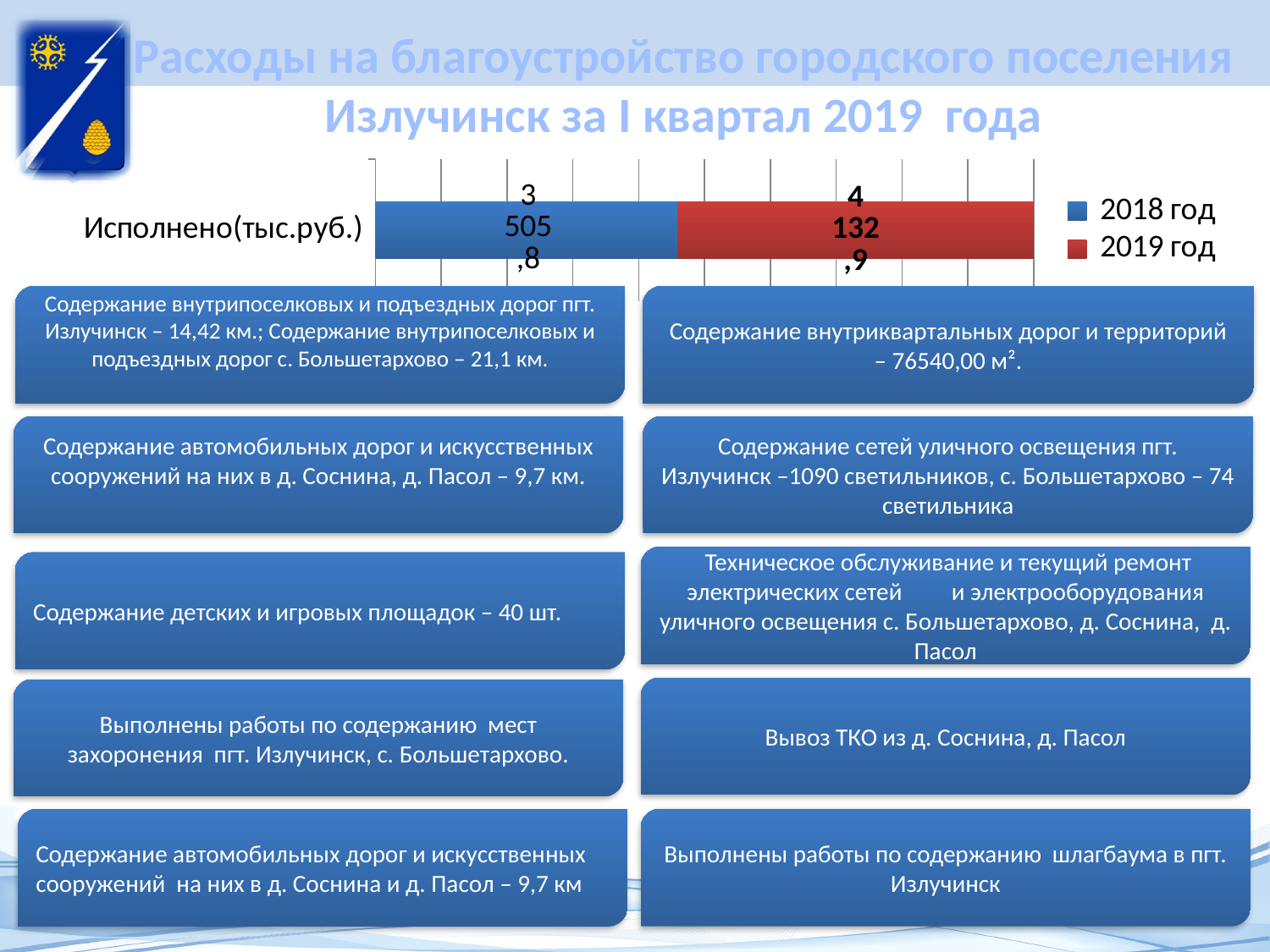
What is the difference between the 2019 год value and the 2018 год value? 627,1 What is the label of the category plotted in the chart? Исполнено(тыс.руб.) Which series has the highest value in the chart? 2019 год How many categories are plotted in the chart? 1 How many series does the legend list? 2 What kind of chart is shown on the slide? Stacked bar chart Which year has the larger value, 2018 год or 2019 год? 2019 год What is the value for 2019 год in the chart? 4 132,9 Which colour represents 2019 год in the chart? Red What is the value for 2018 год in the chart? 3 505,8 Which series has the lowest value in the chart? 2018 год What is the total of the stacked bar for Исполнено(тыс.руб.)? 7 638,7